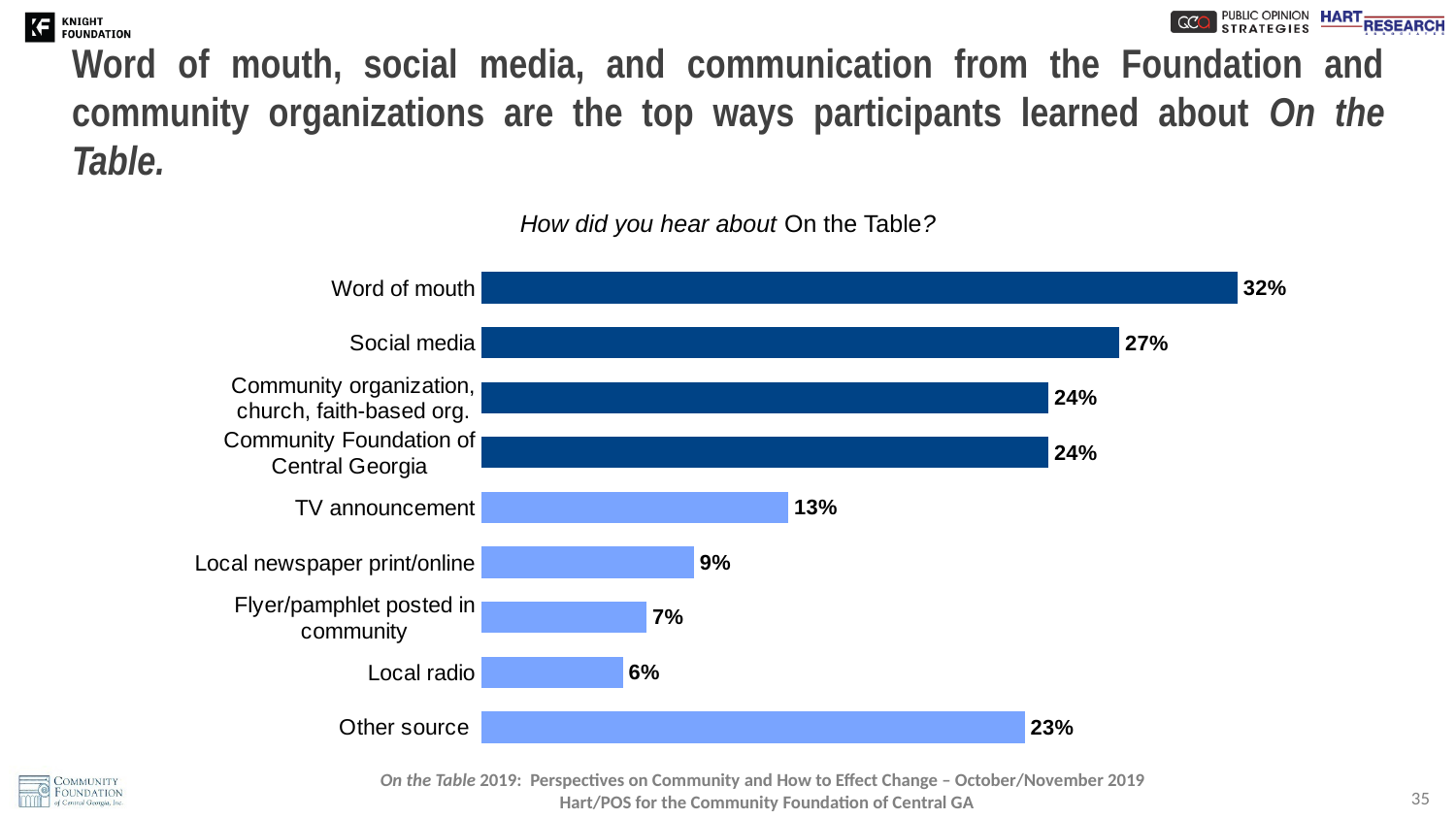
What is the difference between Other source and TV announcement? 10 percentage points Which is larger, Local newspaper print/online or Flyer/pamphlet posted in community? Local newspaper print/online What is the difference between Word of mouth and Social media? 5 percentage points What kind of chart is shown on the slide? Bar chart What is the value for Local radio? 6% Which source has the lowest percentage? Local radio What percentage of participants heard about On the Table through word of mouth? 32% What is the value for Social media? 27% What question does the chart title ask? How did you hear about On the Table? What percentage heard about On the Table from a TV announcement? 13% How many sources are shown in the chart? 9 Which source has the highest percentage? Word of mouth